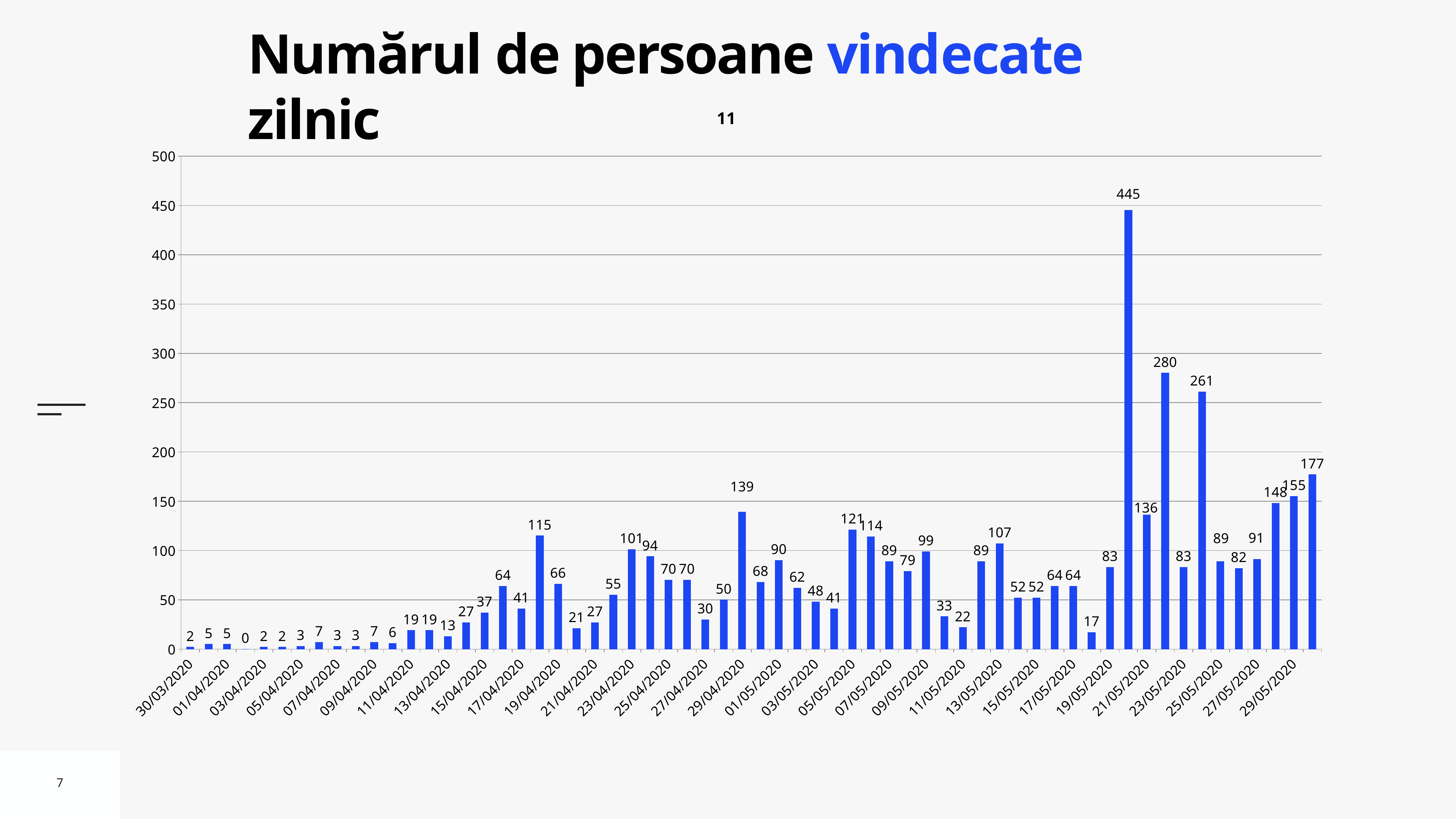
What is the highest value shown in the chart? 445 Is the value for 19/05/2020 greater or less than 100? less What is the value for 21/05/2020? 136 What is the value for 29/04/2020? 139 What is the lowest value shown in the chart? 0 What kind of chart is shown on the slide? bar chart Which date has the larger value, 23/04/2020 or 09/05/2020? 23/04/2020 What is the value for 05/05/2020? 121 What is the value for 13/05/2020? 107 What is the title of the slide? Numărul de persoane vindecate zilnic What is the difference between the values for 29/05/2020 and 27/05/2020? 64 What is the first date label on the x axis? 30/03/2020